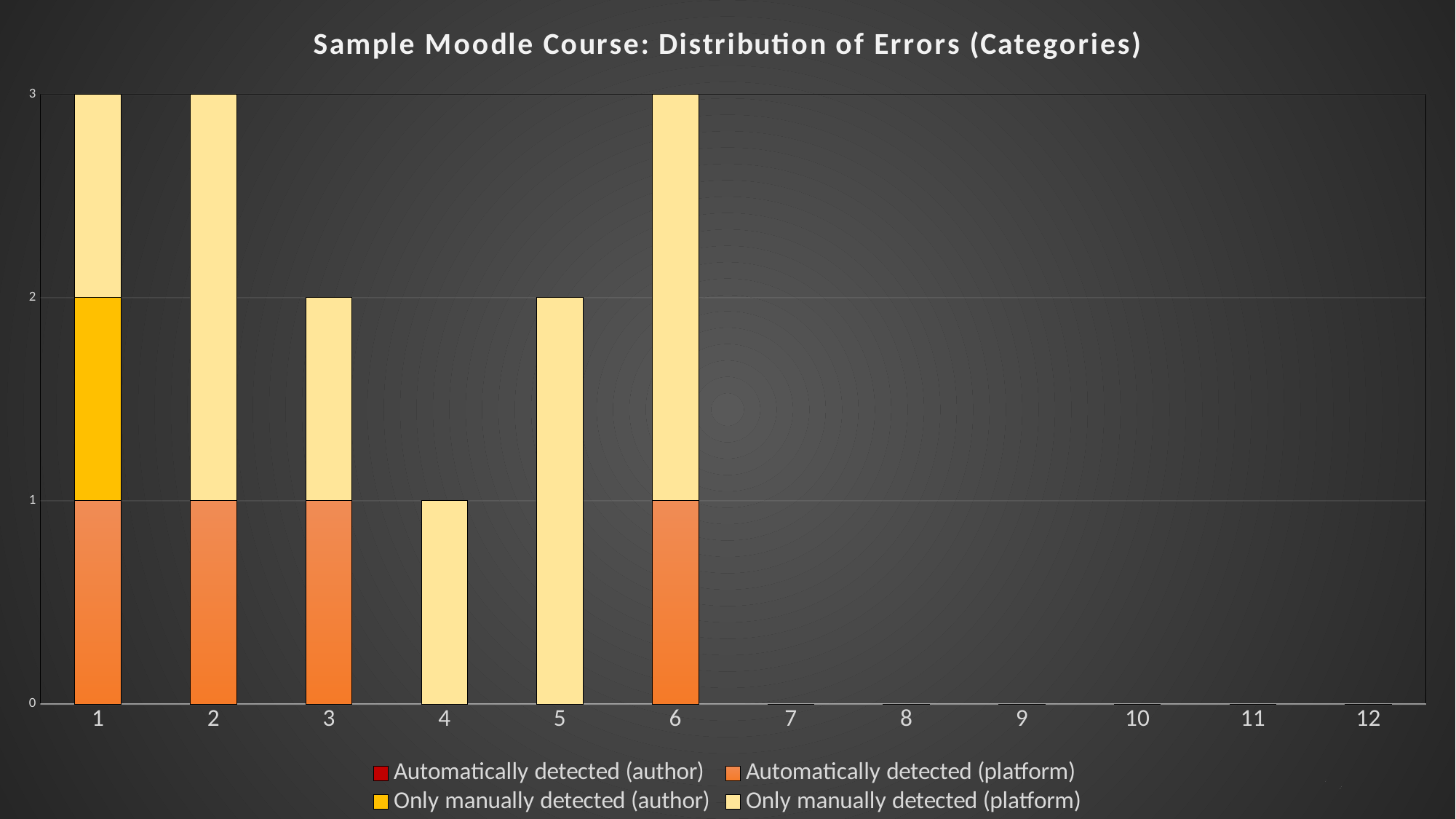
How many series does the legend list? 4 What kind of chart is shown on the slide? stacked bar chart What is the difference between the total for category 2 and the total for category 4? 2 What is the total height of the stacked bar for category 4? 1 What is the value of 'Only manually detected (platform)' for category 5? 2 What is the total height of the stacked bar for category 3? 2 What is the title of the chart? Sample Moodle Course: Distribution of Errors (Categories) What is the value of 'Automatically detected (platform)' for category 6? 1 Which category is the only one with a non-zero value for 'Only manually detected (author)'? 1 What is the total height of the stacked bar for category 1? 3 Is the total for category 4 larger or smaller than the total for category 5? smaller How many categories are shown on the x axis? 12